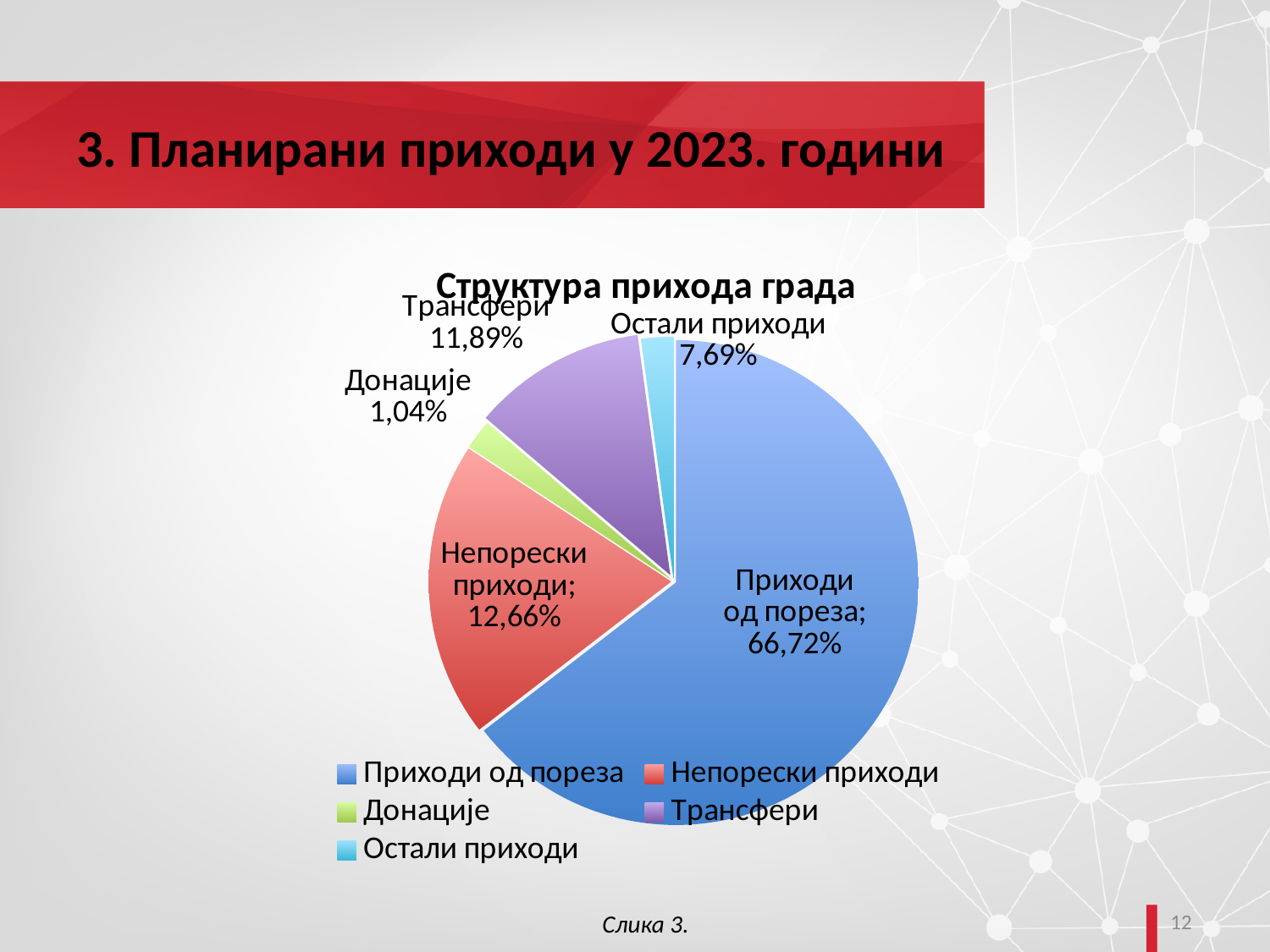
What percentage is shown for Трансфери? 11,89% Which category has the largest slice of the pie? Приходи од пореза What kind of chart is shown on the slide? Pie chart What share of the pie does Остали приходи represent? 7,69% What is the title of the chart? Структура прихода града What share of the pie does Приходи од пореза represent? 66,72% How many categories are shown in the pie chart? 5 What is the value shown for Непорески приходи? 12,66% What is the difference between the shares of Непорески приходи and Трансфери? 0,77% Which category has the smallest slice of the pie? Донације Which is larger, the share for Трансфери or the share for Остали приходи? Трансфери What is the value shown for Донације? 1,04%